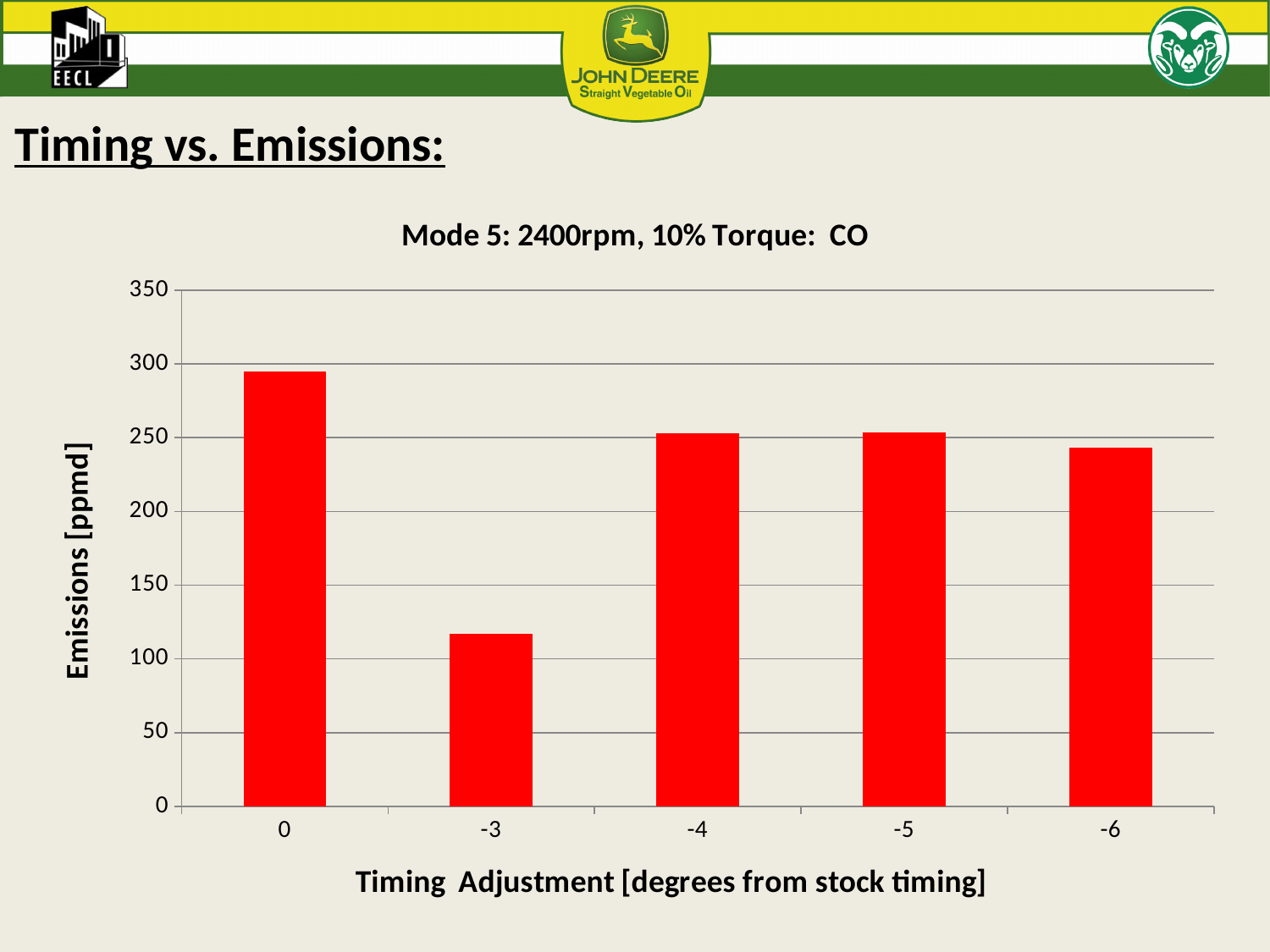
Is the emissions value for timing adjustment -3 greater or less than 150? less Is the emissions value for timing adjustment 0 greater or less than 300? less What is the label of the y axis? Emissions [ppmd] Which timing adjustment has the highest CO emissions? 0 What is the title of the chart? Mode 5: 2400rpm, 10% Torque: CO Is the emissions value for timing adjustment 0 greater or less than 250? greater Which has higher CO emissions, timing adjustment -3 or timing adjustment -6? -6 How many timing adjustment categories are plotted on the x axis? 5 Which has higher CO emissions, timing adjustment 0 or timing adjustment -4? 0 What kind of chart is shown on the slide? bar chart Which timing adjustment has the lowest CO emissions? -3